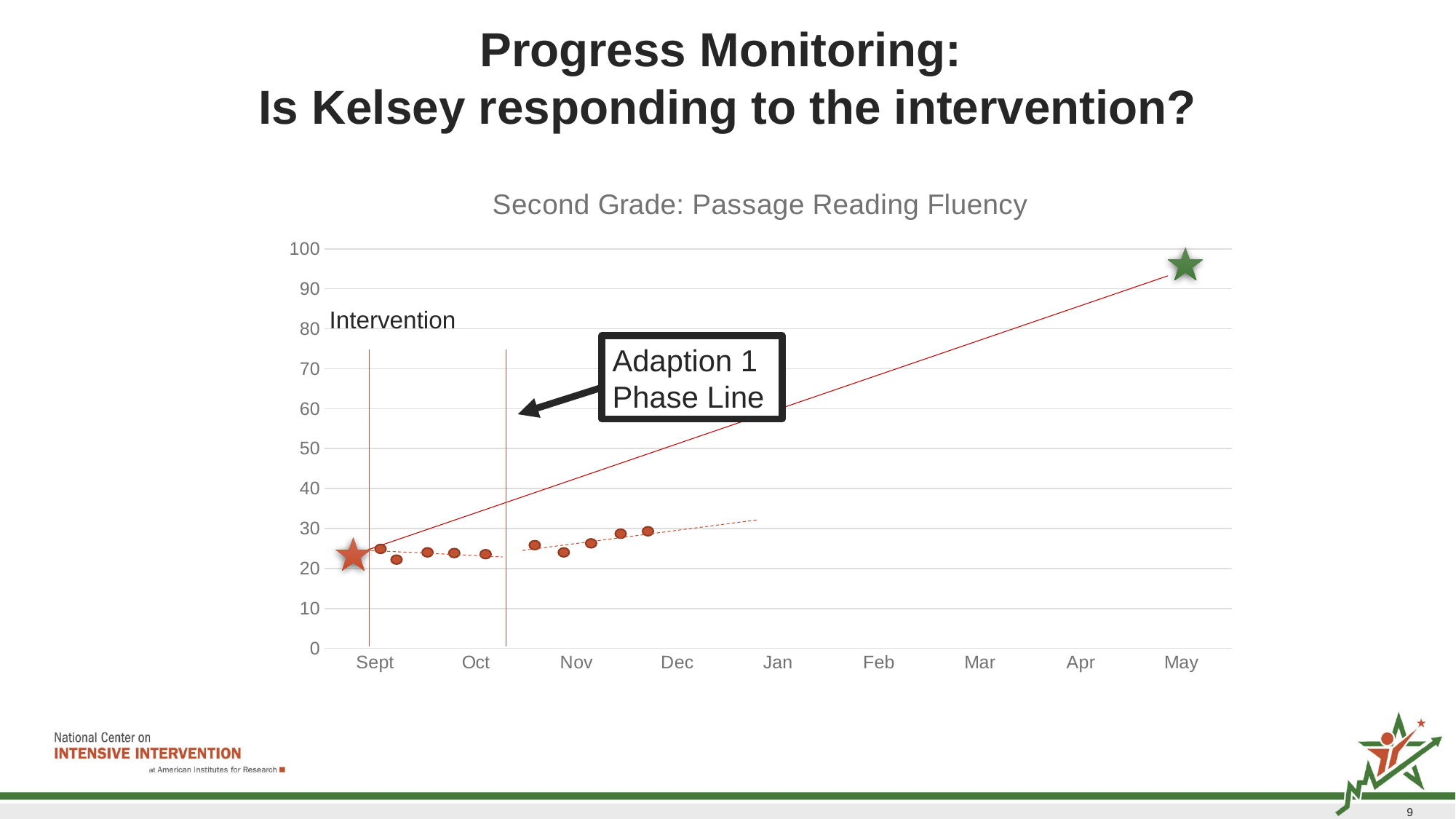
Is the value of the orange star at the start of the chart greater or less than 30? less Which month label is last on the x axis? May Is the value of the green goal star in May greater or less than 90? greater How many month labels are shown along the x axis? 9 What kind of chart is shown on the slide? Line chart with data points (scatter) How many progress-monitoring data points are plotted on the chart? 10 What is the title of the chart? Second Grade: Passage Reading Fluency Which is higher: the green star in May or the orange star near Sept? The green star in May After the Adaption 1 Phase Line, do the plotted data points generally rise or fall? rise Are all of the plotted progress-monitoring data points greater or less than 40? less What is the highest value shown on the y axis? 100 Which month label is first on the x axis? Sept